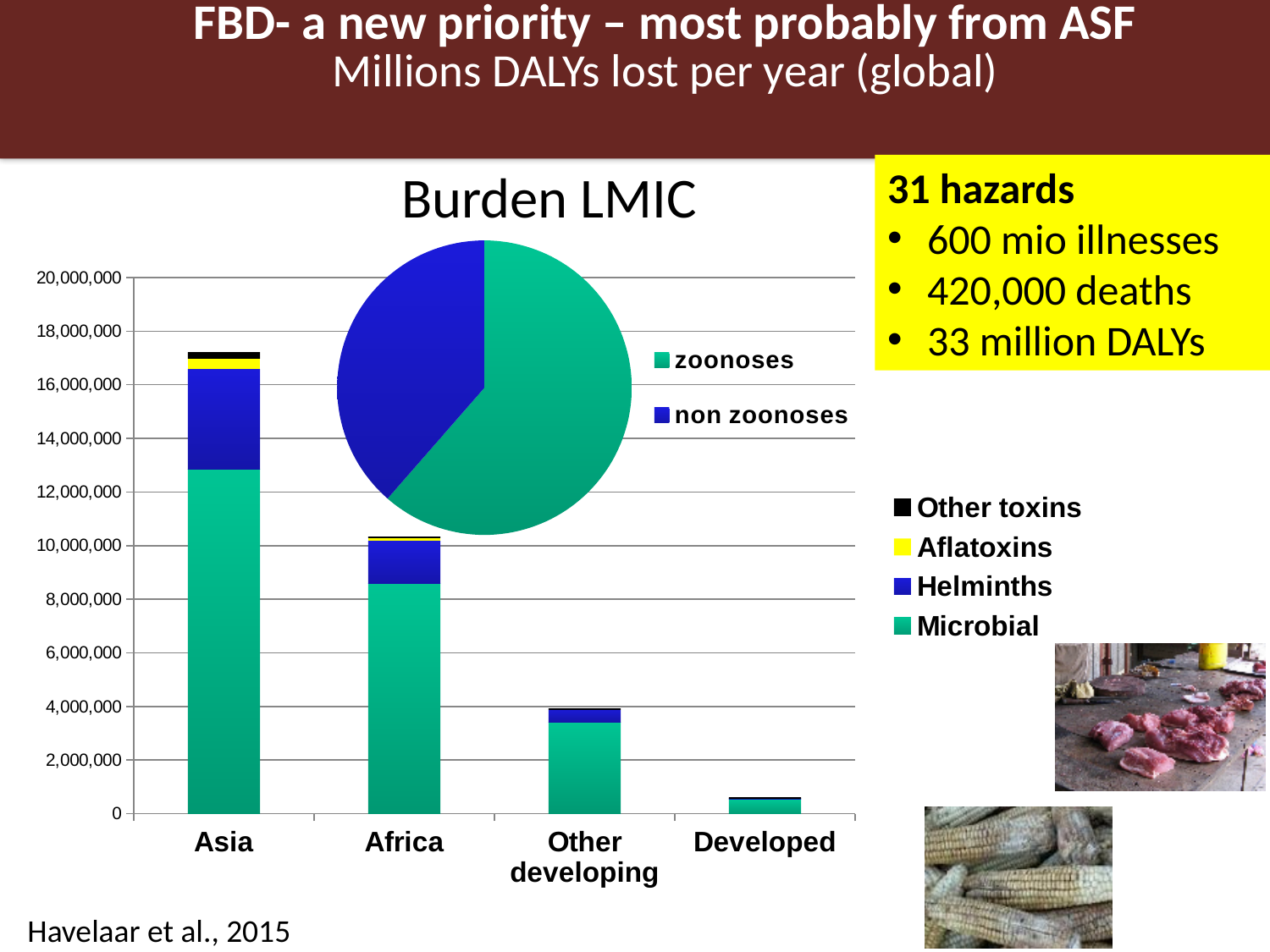
In the stacked bar chart, which series is shown in yellow in the legend? Aflatoxins In the pie chart titled Burden LMIC, which slice is larger, zoonoses or non zoonoses? zoonoses How many categories are shown on the x axis of the stacked bar chart? 4 In the stacked bar chart, which has a larger total bar, Africa or Other developing? Africa In the stacked bar chart, is the total value for Africa greater or less than 12,000,000? less In the stacked bar chart, is the total value for Other developing greater or less than 2,000,000? greater How many series does the legend of the stacked bar chart list? 4 In the stacked bar chart, which category has the lowest total bar? Developed In the stacked bar chart, is the total value for Asia greater or less than 16,000,000? greater In the stacked bar chart, which category has the highest total bar? Asia What kind of chart is the chart with the Asia, Africa, Other developing and Developed categories? Stacked bar chart